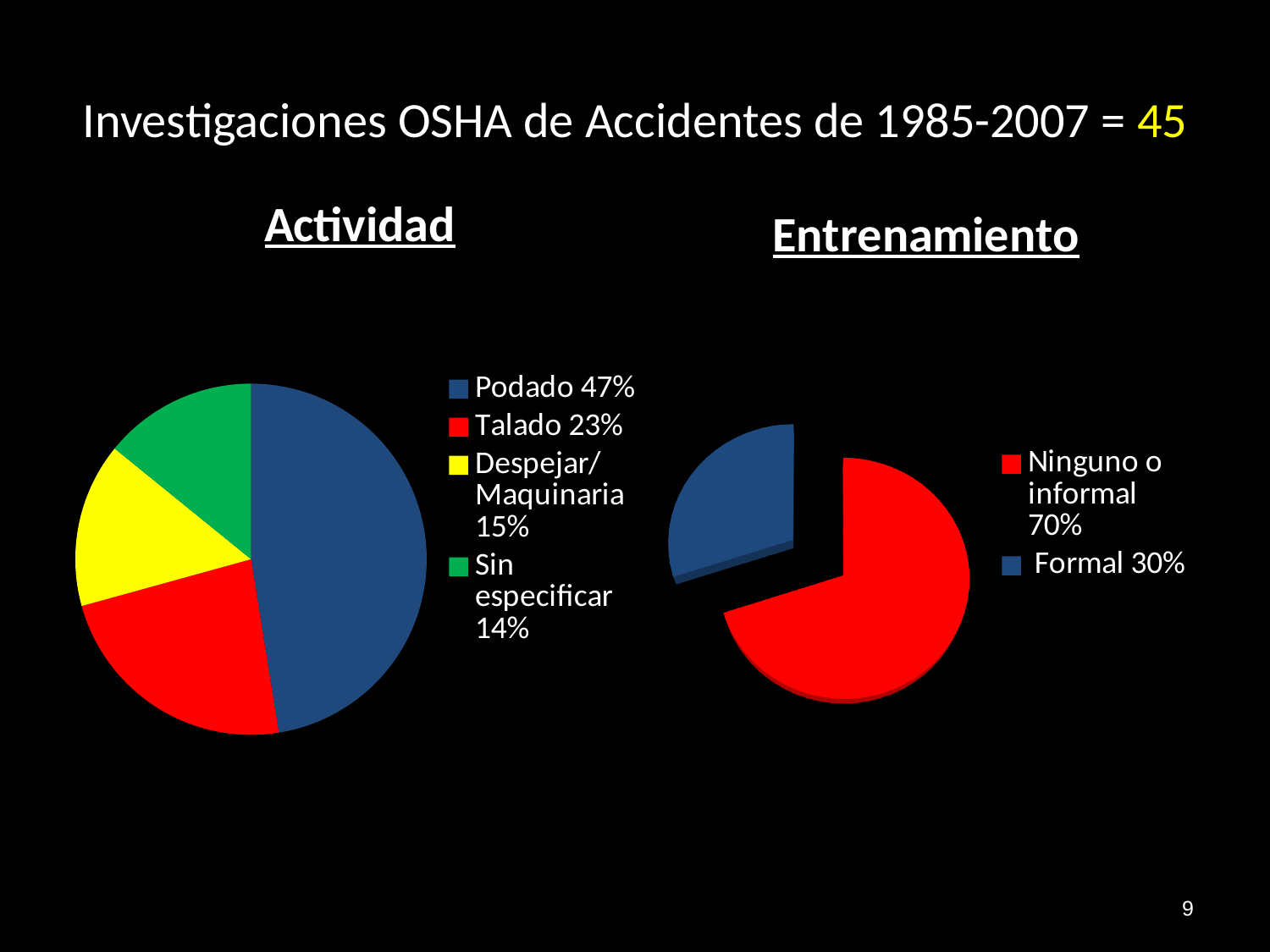
In the Actividad chart, what share does Talado have? 23% In the Actividad chart, which category has the largest slice? Podado In the Entrenamiento chart, what colour is the Formal slice? Blue In the Actividad chart, which category has the smallest slice? Sin especificar In the Entrenamiento chart, which is larger, Ninguno o informal or Formal? Ninguno o informal In the Actividad chart, what share does Podado have? 47% What kind of chart is the Entrenamiento chart? Pie chart In the Entrenamiento chart, what share does Formal have? 30% In the Actividad chart, how many categories are shown? 4 In the Actividad chart, what is the difference between the Podado and Talado shares? 24%